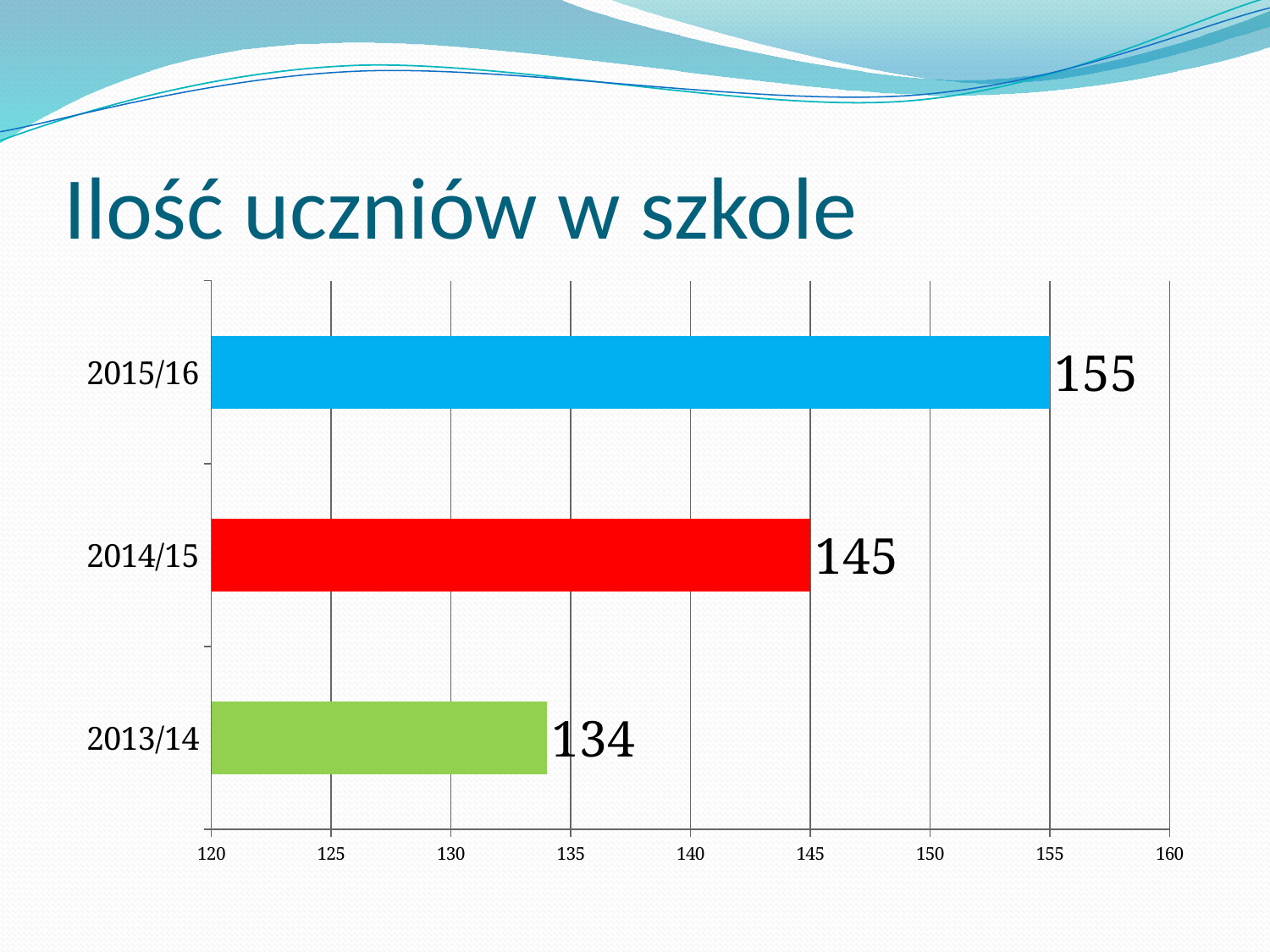
What is the difference between the values for 2015/16 and 2013/14? 21 Is the value for 2014/15 greater or less than 140? greater How many school years are shown in the chart? 3 Which school year has the highest value? 2015/16 Which is larger, the value for 2014/15 or the value for 2013/14? 2014/15 What kind of chart is shown on the slide? bar chart What is the title of the slide? Ilość uczniów w szkole What is the value for 2015/16? 155 What is the difference between the values for 2014/15 and 2013/14? 11 Which school year has the lowest value? 2013/14 What is the value for 2013/14? 134 What is the value for 2014/15? 145